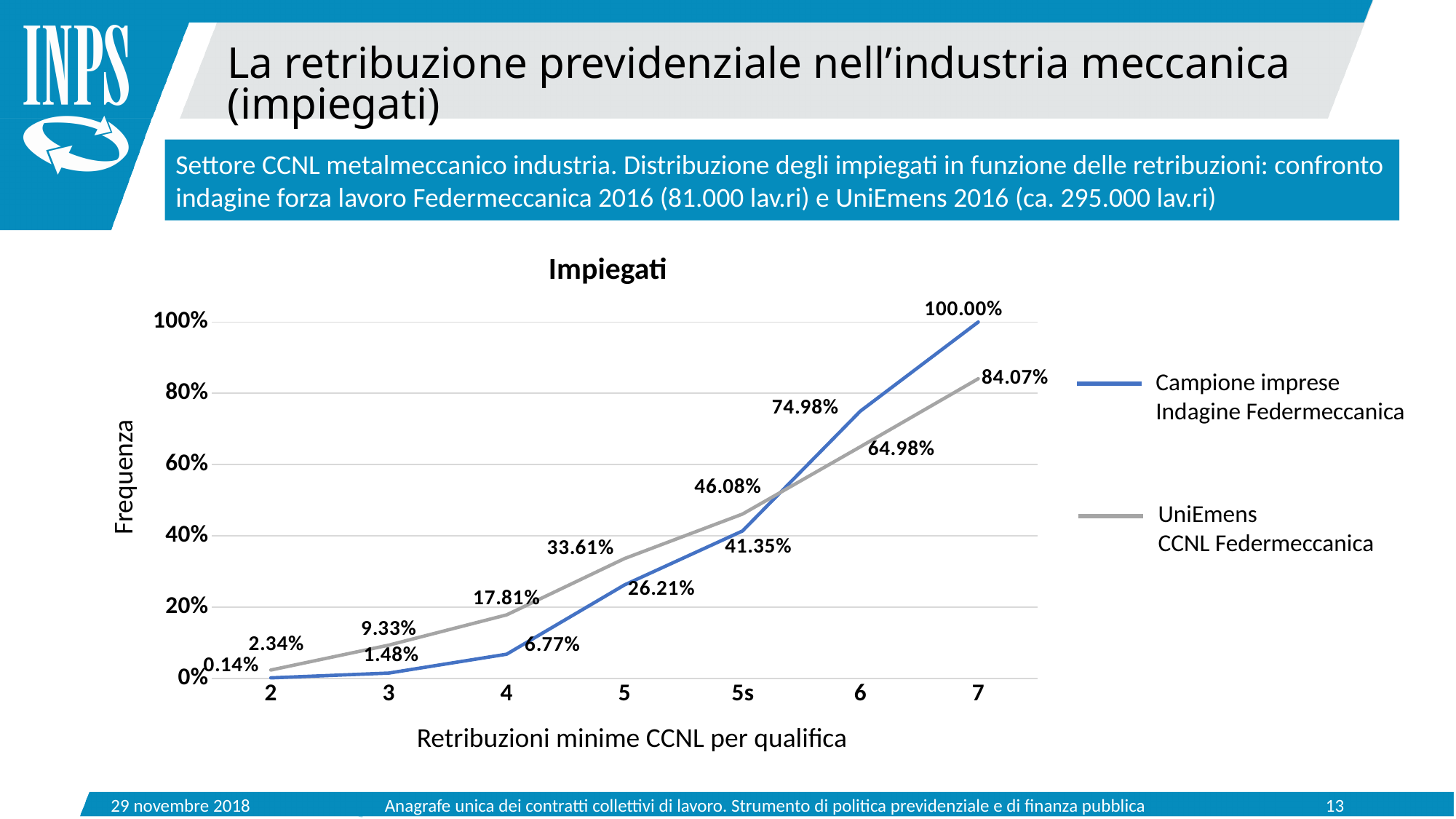
What is the value for Campione imprese Indagine Federmeccanica at category 5? 26.21% At category 5s, which series has the larger value? UniEmens CCNL Federmeccanica Which category has the lowest value for Campione imprese Indagine Federmeccanica? 2 How many categories are shown on the x axis? 7 What is the difference between the two series at category 7? 15.93% What kind of chart is shown on the slide? line chart Which category has the highest value for UniEmens CCNL Federmeccanica? 7 How many series does the legend list? 2 What is the title of the chart? Impiegati What is the value for UniEmens CCNL Federmeccanica at category 7? 84.07% What is the value for UniEmens CCNL Federmeccanica at category 4? 17.81% Do the values for Campione imprese Indagine Federmeccanica rise or fall along the x axis? rise